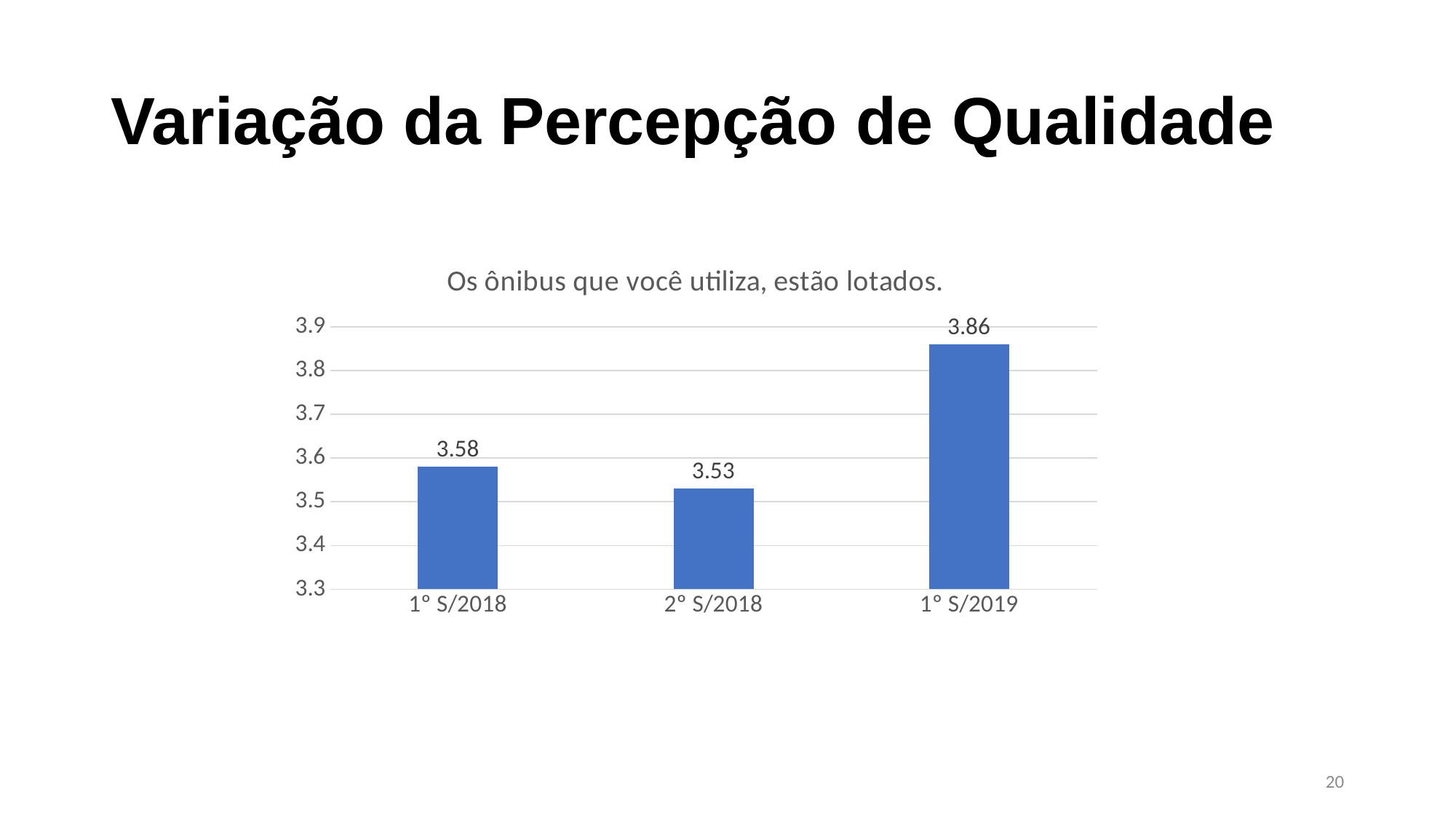
What is the value for 1° S/2019? 3.86 Is the value for 1° S/2019 greater or less than 3.8? greater What is the value for 2° S/2018? 3.53 Which category has the lowest value? 2° S/2018 What is the title of the chart? Os ônibus que você utiliza, estão lotados. Which is larger, the value for 1° S/2018 or the value for 1° S/2019? 1° S/2019 Which category has the highest value? 1° S/2019 How many categories are shown on the x axis? 3 What is the value for 1° S/2018? 3.58 What kind of chart is shown on the slide? bar chart What is the difference between the values for 1° S/2018 and 2° S/2018? 0.05 What is the difference between the values for 1° S/2019 and 2° S/2018? 0.33